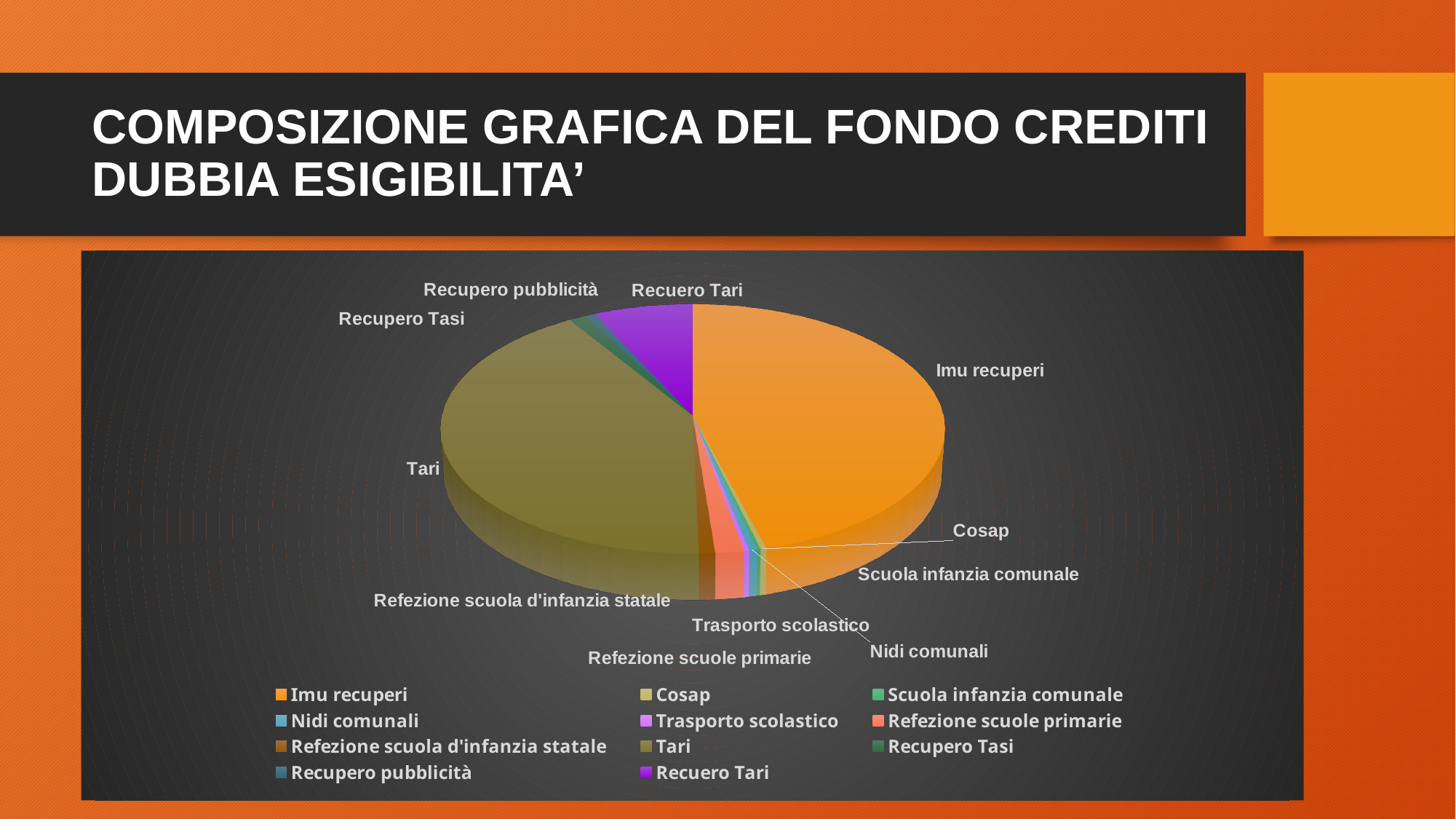
What is the title of the slide containing the pie chart? COMPOSIZIONE GRAFICA DEL FONDO CREDITI DUBBIA ESIGIBILITA' Which slice is larger, Tari or Recuero Tari? Tari What colour is the Recuero Tari slice in the pie chart? Purple What kind of chart is shown on the slide? Pie chart Which slice is larger, Tari or Trasporto scolastico? Tari How many categories does the legend of the pie chart list? 11 Which slice is larger, Imu recuperi or Refezione scuole primarie? Imu recuperi